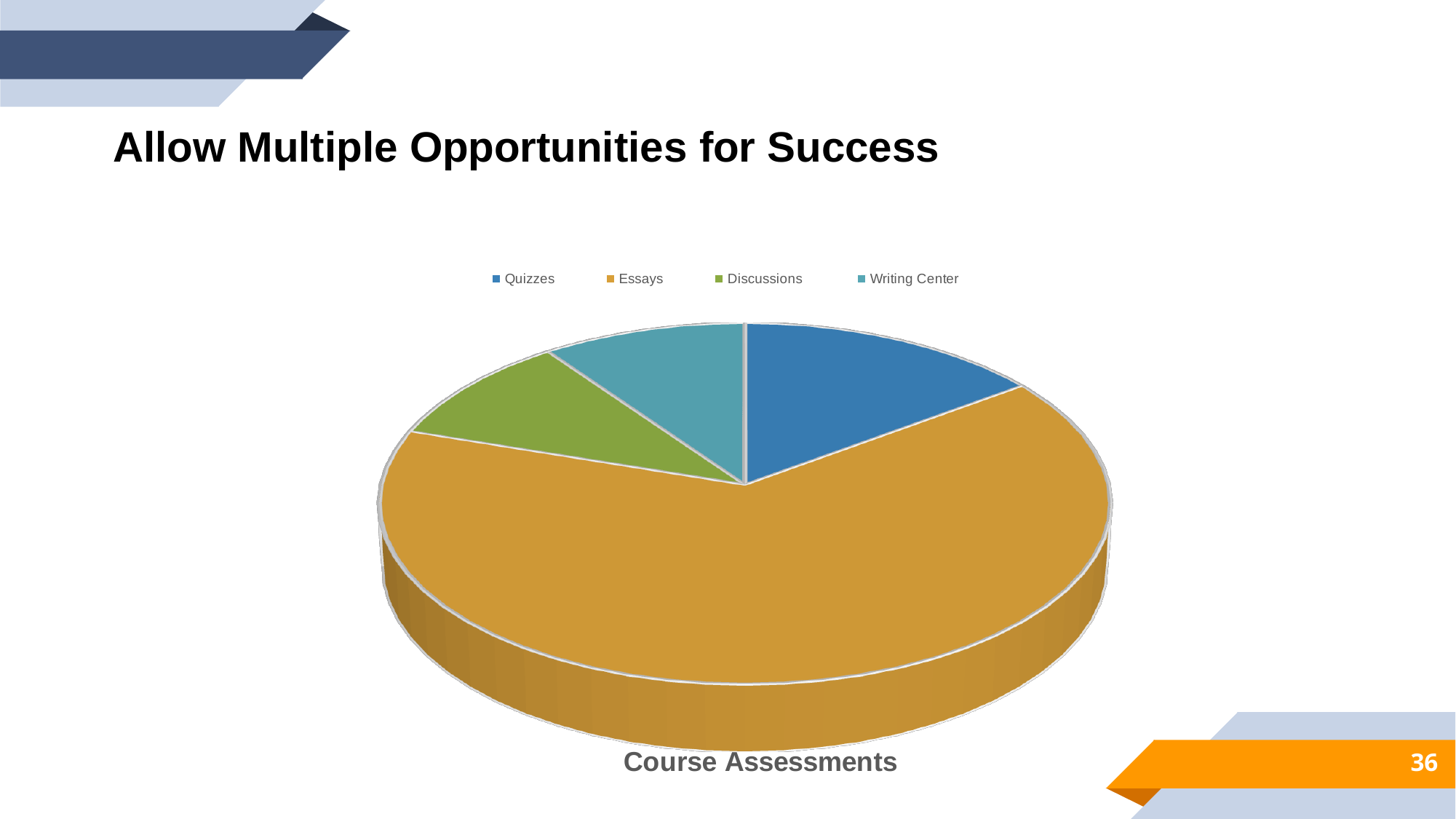
How many categories does the pie chart have? 4 Does the Essays slice make up more or less than half of the pie? more Which category has the largest slice of the pie? Essays What is the title of the chart? Course Assessments How many entries does the legend list? 4 Which is larger, the slice for Essays or the slice for Quizzes? Essays Which is larger, the slice for Essays or the slice for Discussions? Essays What kind of chart is shown on the slide? pie chart What colour is the Essays slice? orange